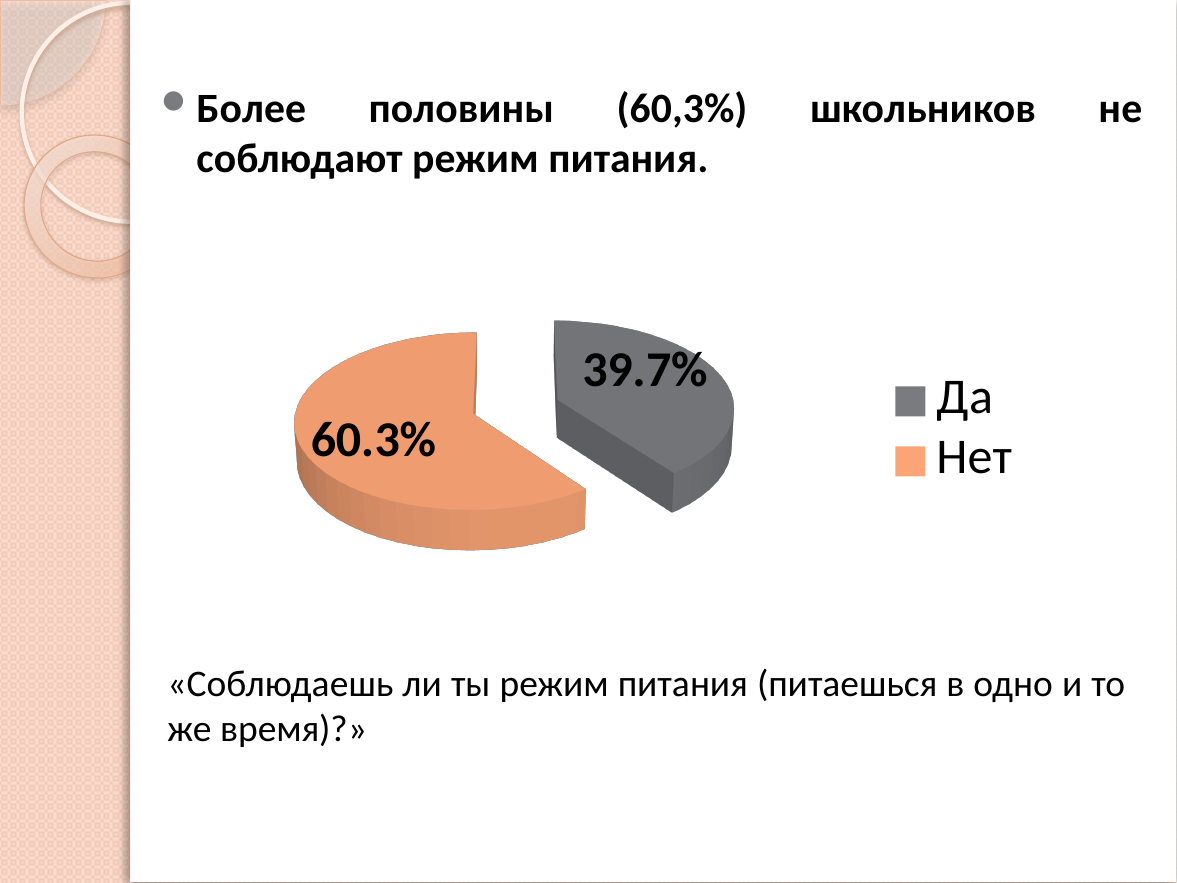
What is the difference between the "Нет" and "Да" slices? 20.6% What colour is the "Да" slice in the pie chart? grey How many entries does the legend list? 2 What kind of chart is shown on the slide? pie chart Which category has the smallest slice in the pie chart? Да Which is larger, the "Да" slice or the "Нет" slice? Нет Which category has the largest slice in the pie chart? Нет What is the value for "Да" in the pie chart? 39.7% What is the value for "Нет" in the pie chart? 60.3% What colour is the "Нет" slice in the pie chart? orange What share of the pie does the "Да" slice represent? 39.7% How many slices does the pie chart have? 2